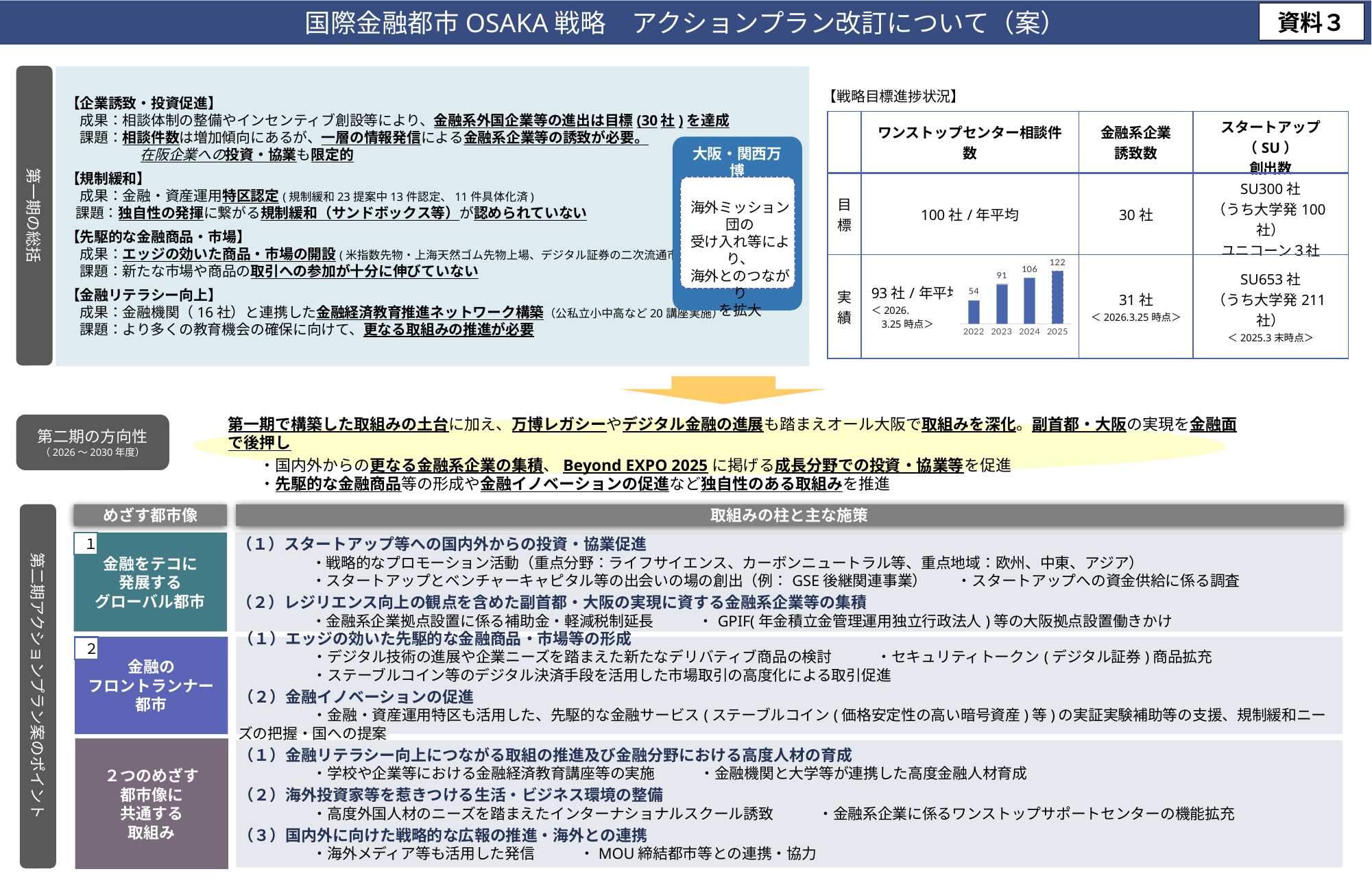
In the small bar chart inside the 戦略目標進捗状況 table, what is the difference between the 2024 and 2023 values? 15 In the small bar chart inside the 戦略目標進捗状況 table, do the values rise or fall from 2022 to 2025? Rise In the small bar chart inside the 戦略目標進捗状況 table, what is the value for 2023? 91 In the small bar chart inside the 戦略目標進捗状況 table, what is the value for 2022? 54 How many years (bars) are shown in the small bar chart inside the 戦略目標進捗状況 table? 4 What kind of chart is shown inside the 戦略目標進捗状況 table? Bar chart In the small bar chart inside the 戦略目標進捗状況 table, which year has the lowest value? 2022 In the small bar chart inside the 戦略目標進捗状況 table, which year has the highest value? 2025 In the small bar chart inside the 戦略目標進捗状況 table, what is the difference between the 2025 and 2022 values? 68 In the small bar chart inside the 戦略目標進捗状況 table, which is larger, the value for 2023 or the value for 2024? 2024 In the small bar chart inside the 戦略目標進捗状況 table, what is the value for 2025? 122 In the small bar chart inside the 戦略目標進捗状況 table, what is the value for 2024? 106